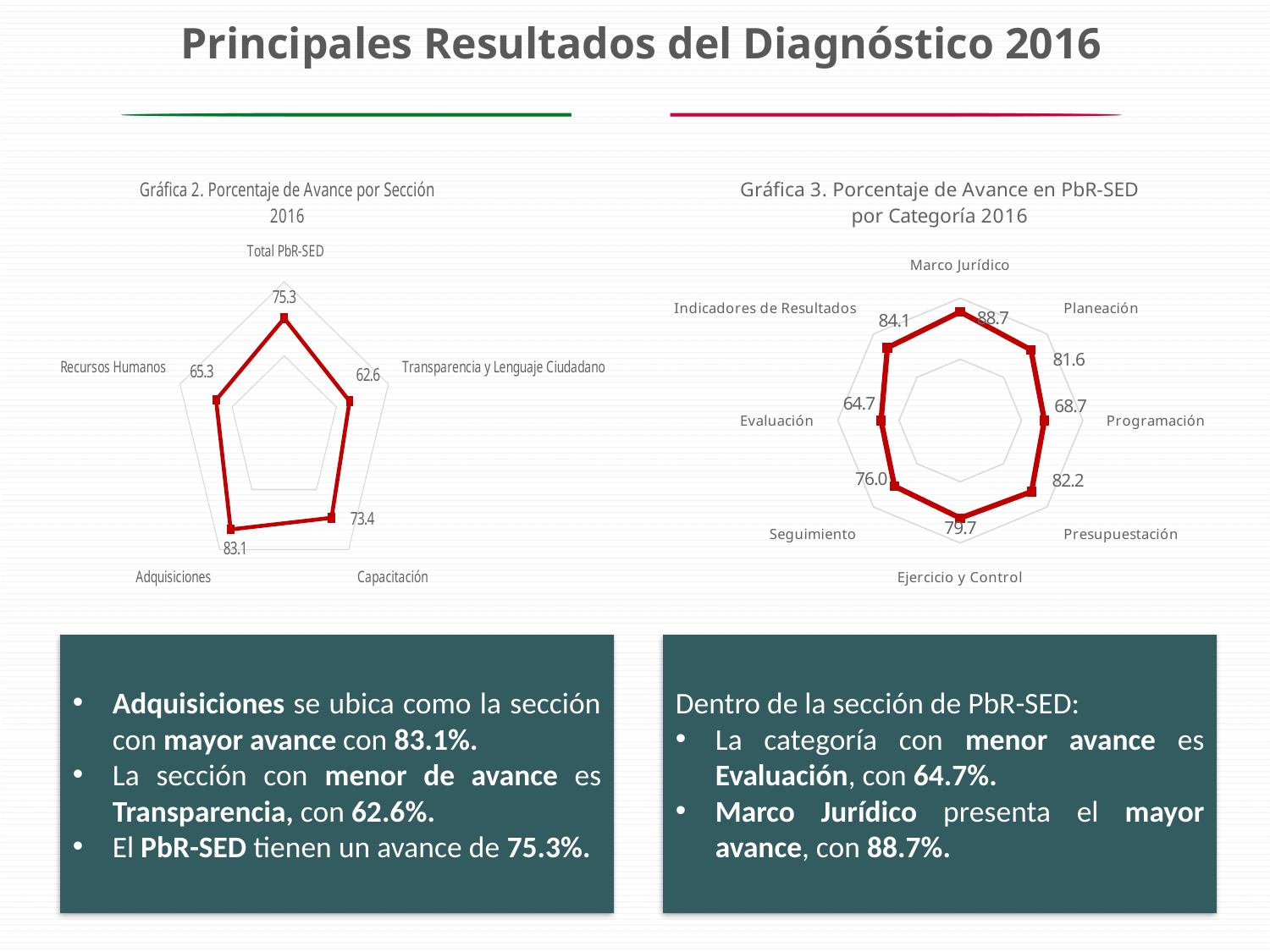
In Gráfica 2 (Porcentaje de Avance por Sección 2016), how many sections are plotted? 5 What kind of chart is Gráfica 3 (Porcentaje de Avance en PbR-SED por Categoría 2016)? Radar chart In Gráfica 3 (Porcentaje de Avance en PbR-SED por Categoría 2016), which category has the lowest value? Evaluación In Gráfica 2 (Porcentaje de Avance por Sección 2016), which section has the highest value? Adquisiciones In Gráfica 2 (Porcentaje de Avance por Sección 2016), what is the value for Adquisiciones? 83.1 In Gráfica 2 (Porcentaje de Avance por Sección 2016), what is the value for Transparencia y Lenguaje Ciudadano? 62.6 In Gráfica 3 (Porcentaje de Avance en PbR-SED por Categoría 2016), how many categories are plotted? 8 In Gráfica 3 (Porcentaje de Avance en PbR-SED por Categoría 2016), what is the value for Marco Jurídico? 88.7 In Gráfica 2 (Porcentaje de Avance por Sección 2016), which section has the lowest value? Transparencia y Lenguaje Ciudadano In Gráfica 3 (Porcentaje de Avance en PbR-SED por Categoría 2016), what is the value for Seguimiento? 76.0 In Gráfica 2 (Porcentaje de Avance por Sección 2016), what is the difference between Adquisiciones and Recursos Humanos? 17.8 In Gráfica 3 (Porcentaje de Avance en PbR-SED por Categoría 2016), which is larger, Planeación or Presupuestación? Presupuestación